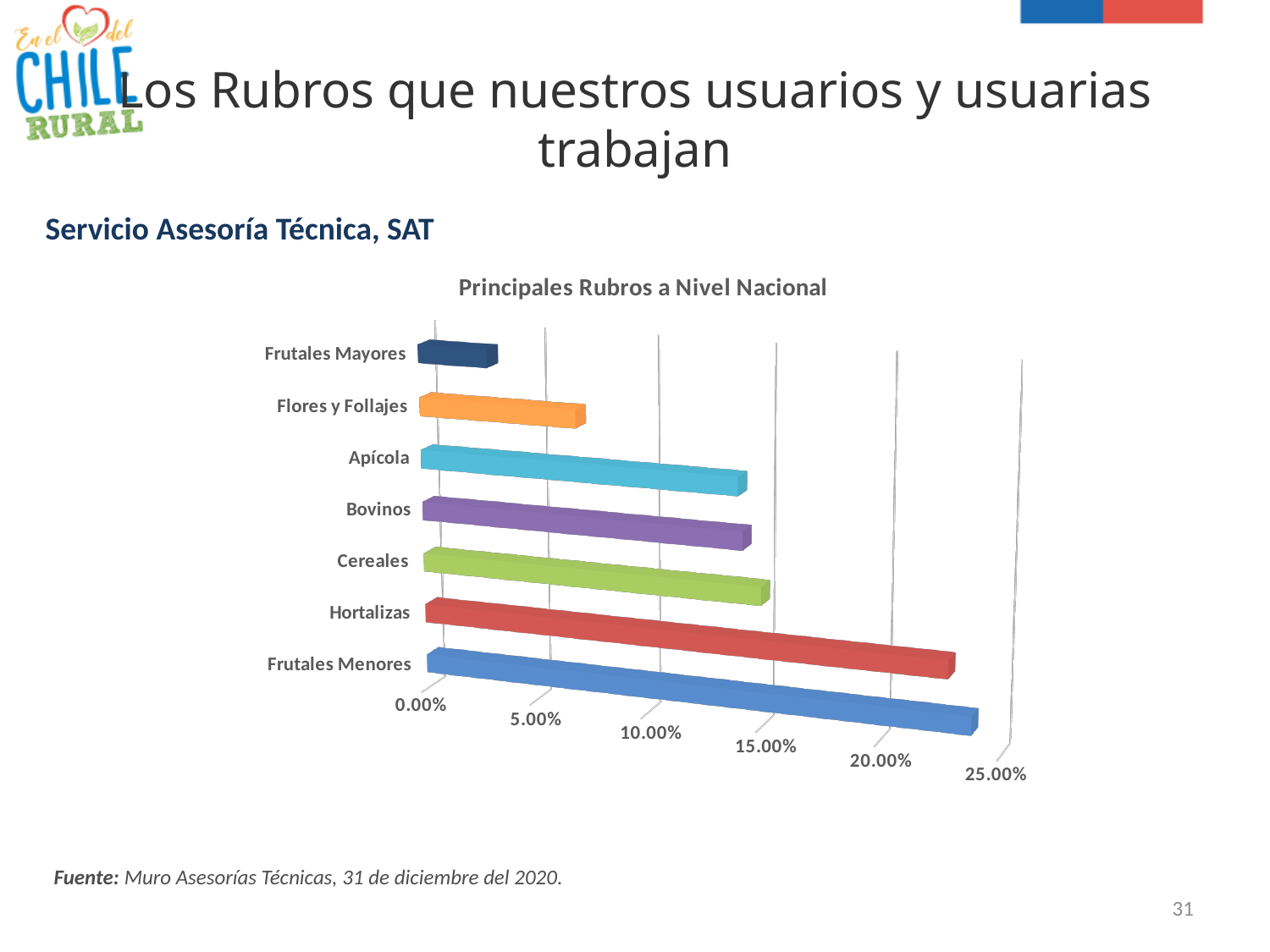
What is the title of the chart? Principales Rubros a Nivel Nacional How many categories (rubros) are shown in the chart? 7 Which has a larger value, Cereales or Frutales Mayores? Cereales Is the value for Frutales Mayores greater or less than 5.00%? less Is the value for Hortalizas greater or less than 20.00%? greater Which has a larger value, Hortalizas or Flores y Follajes? Hortalizas Which category has the highest value in the chart? Frutales Menores Which category has the lowest value in the chart? Frutales Mayores Is the value for Flores y Follajes greater or less than 10.00%? less What type of chart is shown on the slide? bar chart